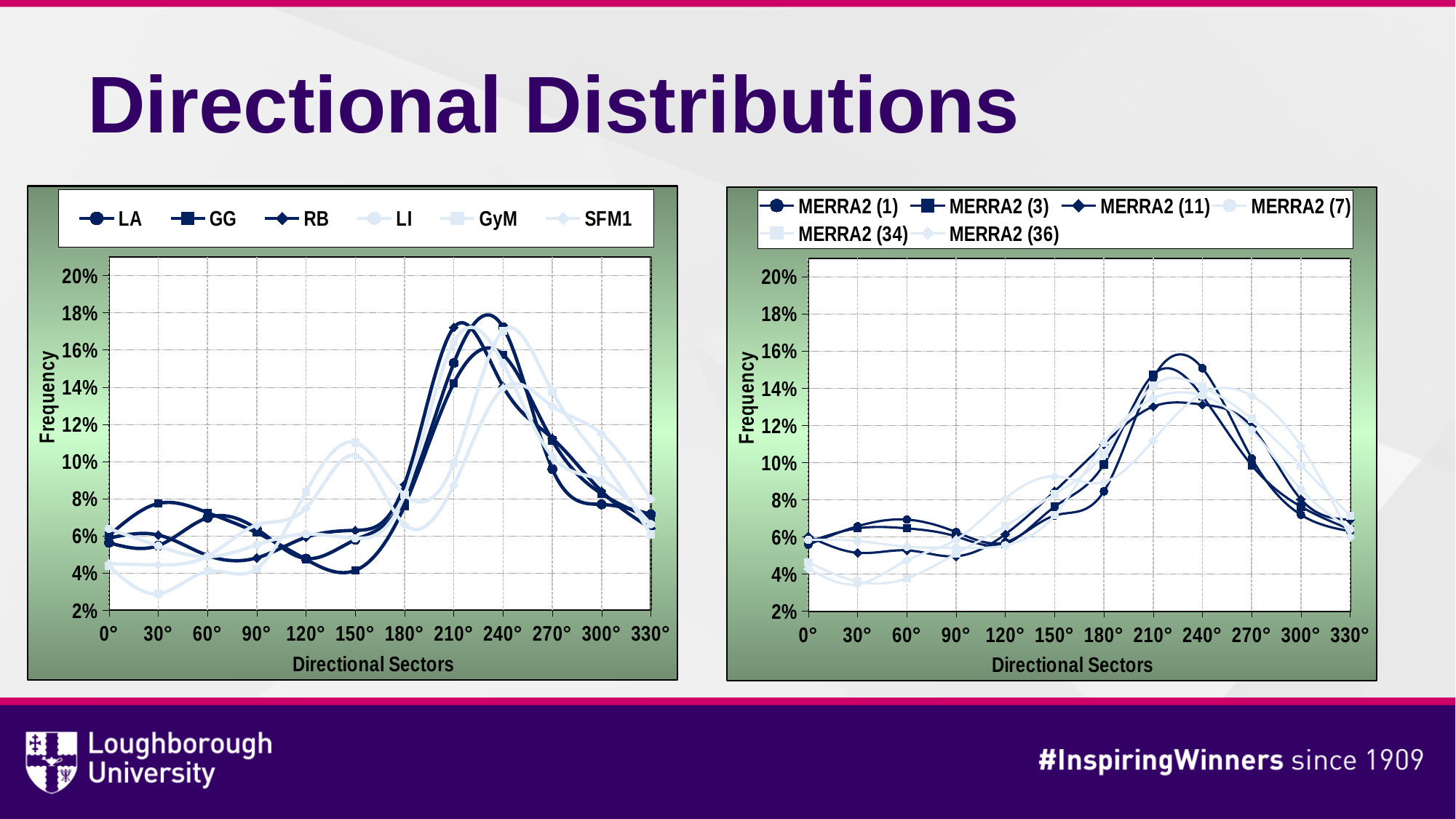
How many series does the legend of the left chart list? 6 How many series does the legend of the right chart list? 6 In the left chart, is the value for GG at 150° greater or less than 6%? less In the left chart, is the value for GG at 30° greater or less than 6%? greater What is the x-axis title of the right chart? Directional Sectors How many directional sector categories are shown on the x axis of the right chart? 12 In the right chart, is the value for MERRA2 (7) at 30° greater or less than 4%? greater In the right chart, which is larger at 30°: MERRA2 (1) or MERRA2 (7)? MERRA2 (1) What is the y-axis title of the left chart? Frequency What type of chart is the left chart on the slide? Line chart In the right chart, does the MERRA2 (1) series rise or fall from 120° to 240°? rise